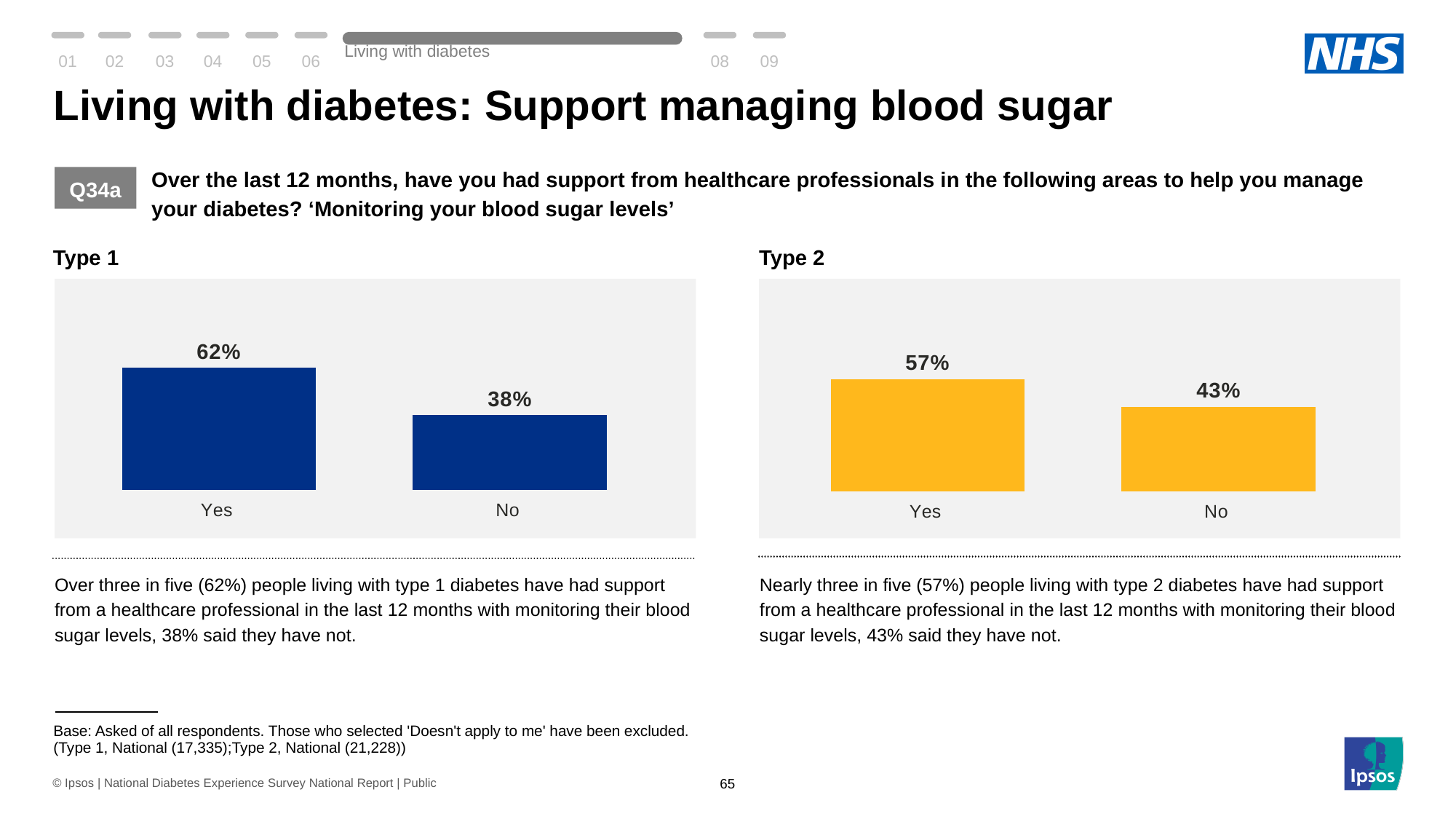
What colour are the bars in the Type 2 chart? Yellow In the Type 2 chart, what percentage of respondents answered Yes? 57% In the Type 2 chart, which category has the lowest value? No In the Type 1 chart, what percentage of respondents answered Yes? 62% How many categories are shown in the Type 2 chart? 2 What kind of chart is the Type 1 chart? Bar chart Which is larger: the Yes value in the Type 1 chart or the Yes value in the Type 2 chart? Type 1 Yes In the Type 2 chart, what is the difference between the Yes and No values? 14% In the Type 1 chart, what is the difference between the Yes and No values? 24% In the Type 2 chart, what percentage of respondents answered No? 43% In the Type 1 chart, which category has the highest value? Yes In the Type 1 chart, what percentage of respondents answered No? 38%